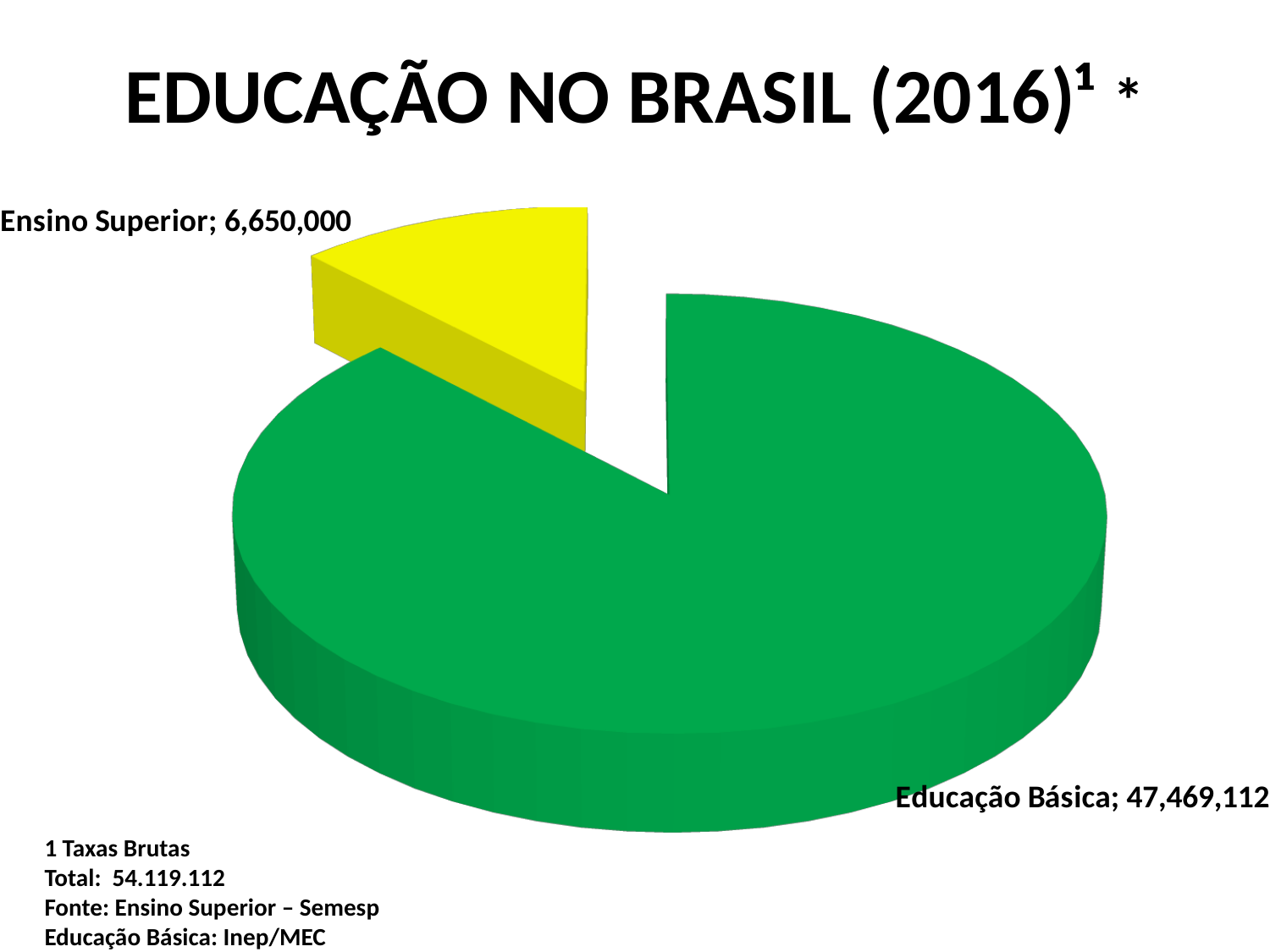
What is the value for Educação Básica? 47,469,112 What colour is the Ensino Superior slice? yellow How many slices does the pie chart have? 2 What kind of chart is shown on the slide? pie chart What is the total of the two slices, as printed on the slide? 54.119.112 What is the title of the slide containing the chart? EDUCAÇÃO NO BRASIL (2016) Which is larger, Ensino Superior or Educação Básica? Educação Básica What is the difference between the values for Educação Básica and Ensino Superior? 40,819,112 Which category has the smallest slice of the pie? Ensino Superior Which category has the largest slice of the pie? Educação Básica What share of the pie does Ensino Superior represent? 12.3% What is the value for Ensino Superior? 6,650,000